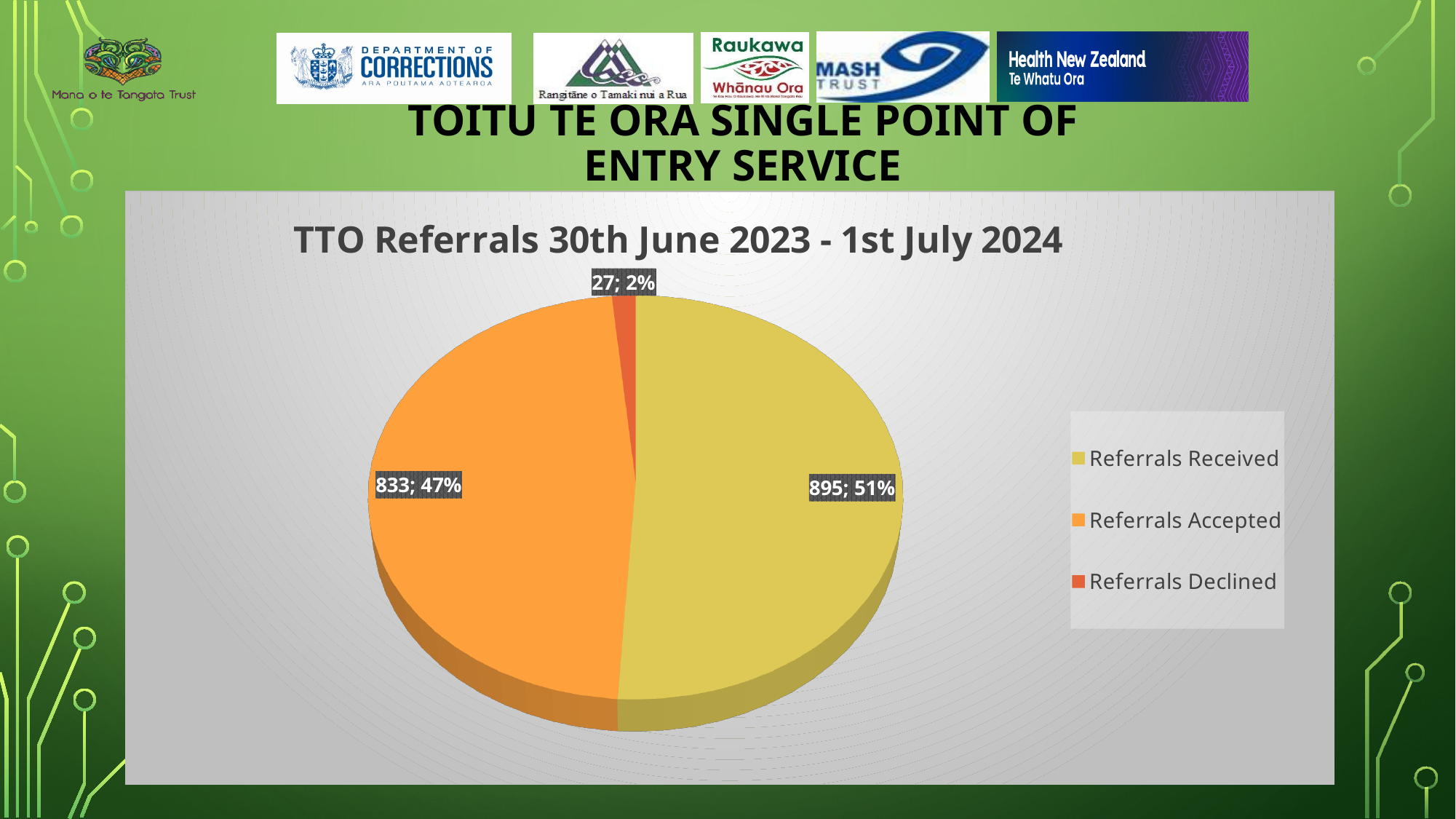
What is the difference between Referrals Received and Referrals Accepted? 62 Which category has the largest slice of the pie? Referrals Received What is the value for Referrals Declined? 27 What share of the pie does Referrals Accepted represent? 47% What kind of chart is shown on the slide? Pie chart How many categories are shown in the pie chart? 3 What is the value for Referrals Received? 895 What is the value for Referrals Accepted? 833 What is the title of the chart? TTO Referrals 30th June 2023 - 1st July 2024 Which is larger, Referrals Accepted or Referrals Declined? Referrals Accepted What share of the pie does Referrals Declined represent? 2% Which category has the smallest slice of the pie? Referrals Declined